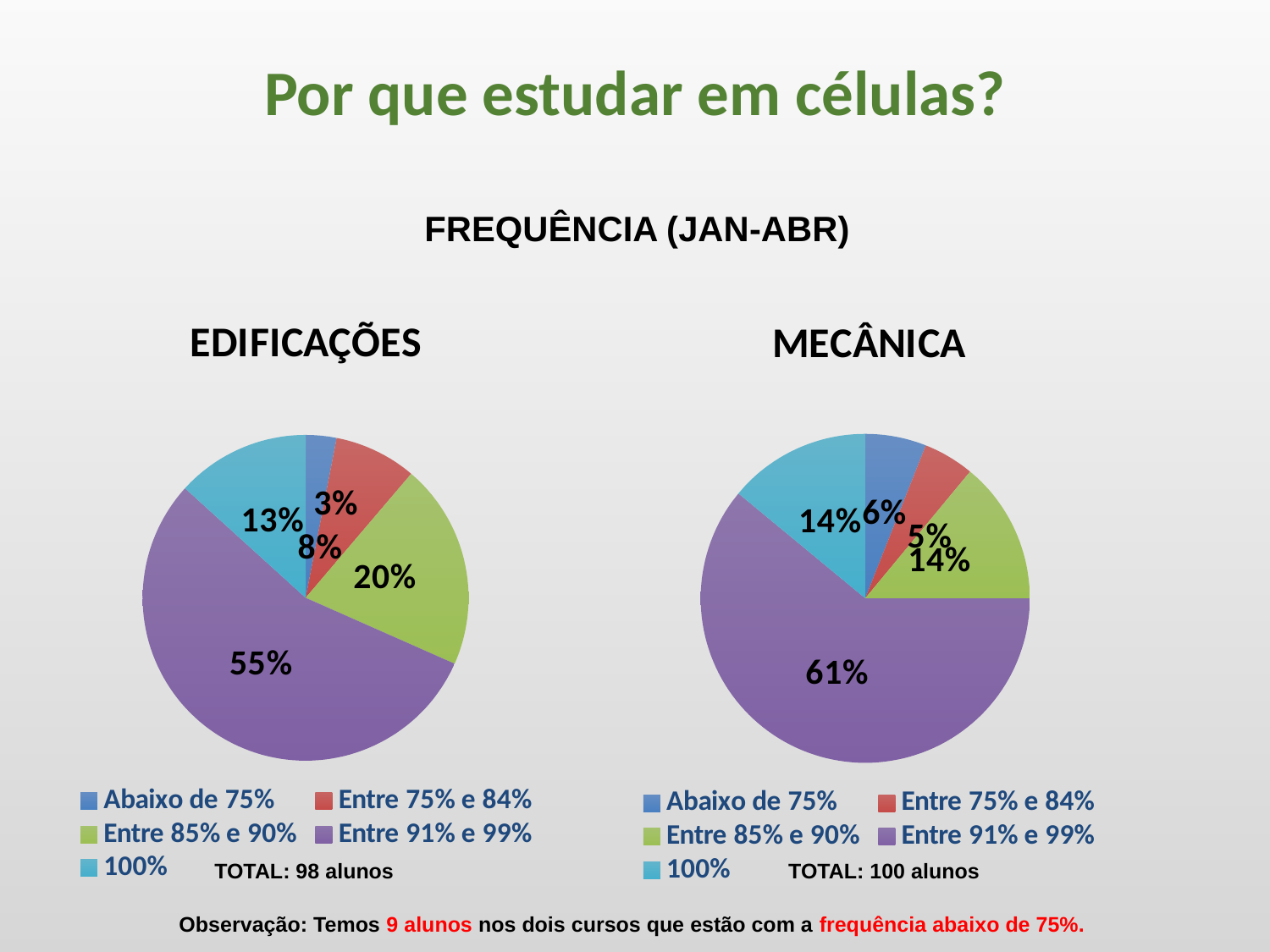
In the EDIFICAÇÕES chart, what is the difference between the 'Entre 85% e 90%' slice and the 'Entre 75% e 84%' slice? 12% What type of chart is used for EDIFICAÇÕES? Pie chart What total number of students is stated below the MECÂNICA chart? 100 alunos How many slices does the MECÂNICA pie chart have? 5 In the MECÂNICA chart, what percentage is shown for the 'Entre 91% e 99%' slice? 61% In the EDIFICAÇÕES chart, which is larger: the 'Entre 85% e 90%' slice or the '100%' slice? Entre 85% e 90% In the MECÂNICA chart, which category has the largest slice? Entre 91% e 99% In the EDIFICAÇÕES chart, what percentage is shown for the 'Entre 91% e 99%' slice? 55% In the EDIFICAÇÕES chart, which category has the smallest slice? Abaixo de 75% In the EDIFICAÇÕES chart, what percentage is shown for the 'Abaixo de 75%' slice? 3% In the EDIFICAÇÕES chart, what percentage is shown for the '100%' slice? 13% In the MECÂNICA chart, what percentage is shown for the 'Abaixo de 75%' slice? 6%